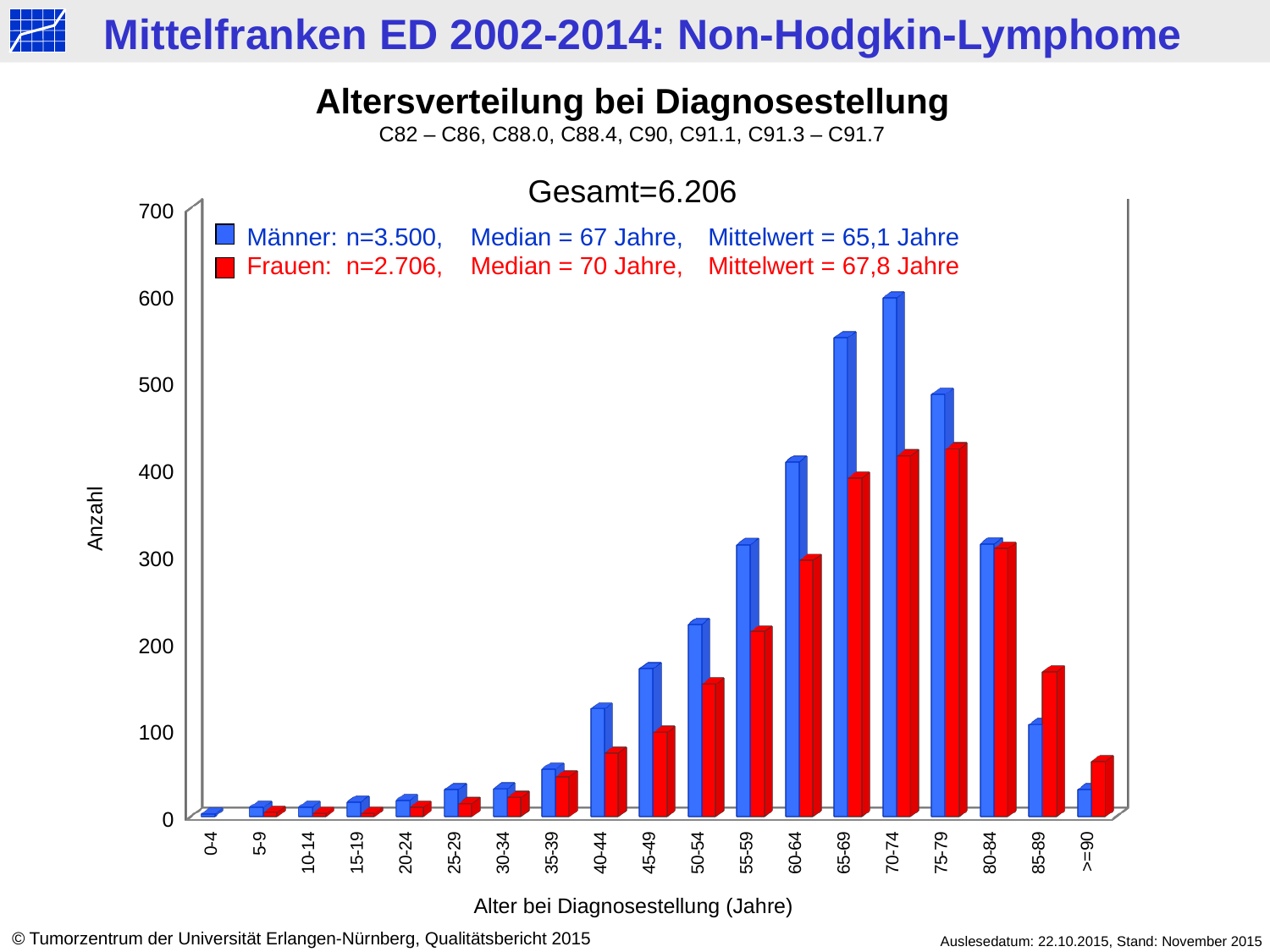
What kind of chart is shown on the slide? bar chart What is the Gesamt value shown above the chart? 6.206 In which age group is the Männer bar lowest? 0-4 In which age group is the Männer bar highest? 70-74 How many age categories are shown on the x axis? 19 Is the Männer value for the 70-74 age group greater or less than 500? greater In the 85-89 age group, which series has the larger value, Männer or Frauen? Frauen What is the label of the y axis? Anzahl Is the Frauen value for the 40-44 age group greater or less than 100? less What is the median age at diagnosis for Frauen given in the legend? 70 Jahre How many series does the legend list? 2 What is the number of cases (n) for Männer given in the legend? n=3.500